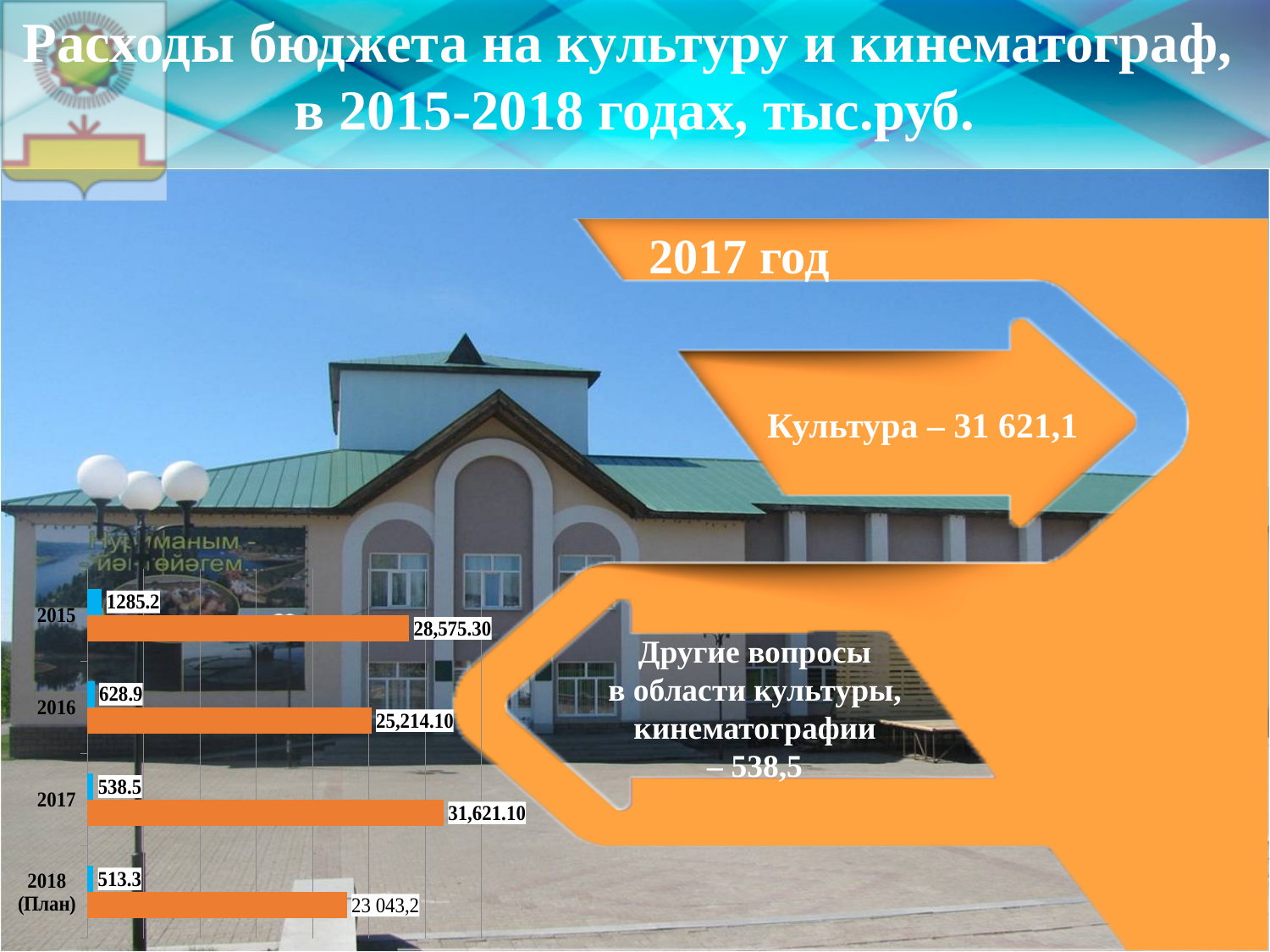
What is the value of the blue bar for 2015? 1285.2 Do the blue bar values rise or fall from 2015 to 2018 (План)? fall How many year categories does the chart show? 4 What kind of chart is shown on the slide? bar chart What is the value of the orange bar for 2018 (План)? 23 043,2 Which year has the larger orange bar value, 2015 or 2016? 2015 Which year has the lowest orange bar value? 2018 (План) What is the difference between the orange bar values for 2017 and 2016? 6,407.00 Which year has the highest orange bar value? 2017 What is the value of the orange bar for 2017? 31,621.10 What is the difference between the blue bar values for 2015 and 2016? 656.3 Which year has the highest blue bar value? 2015